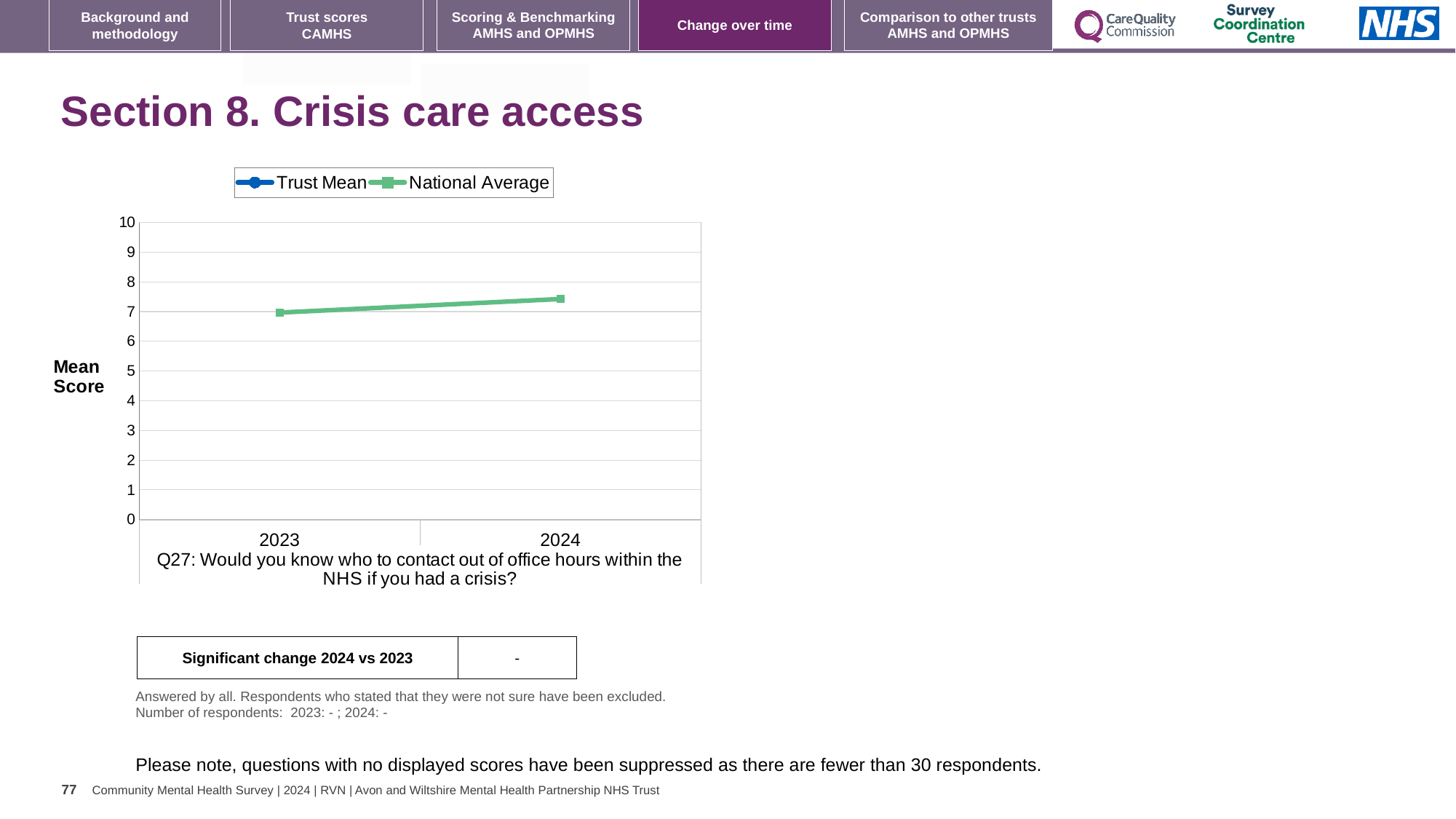
Does the National Average line rise or fall from 2023 to 2024? rise Is the National Average value for 2023 greater or less than 6? greater Which year has the higher National Average value, 2023 or 2024? 2024 How many years are shown on the x axis of the chart? 2 Is the National Average value for 2023 greater or less than 8? less Which series in the legend is shown in green? National Average How many series does the chart legend list? 2 Is the National Average value for 2024 greater or less than 7? greater What kind of chart is shown on the slide? line chart What is the label on the y axis of the chart? Mean Score